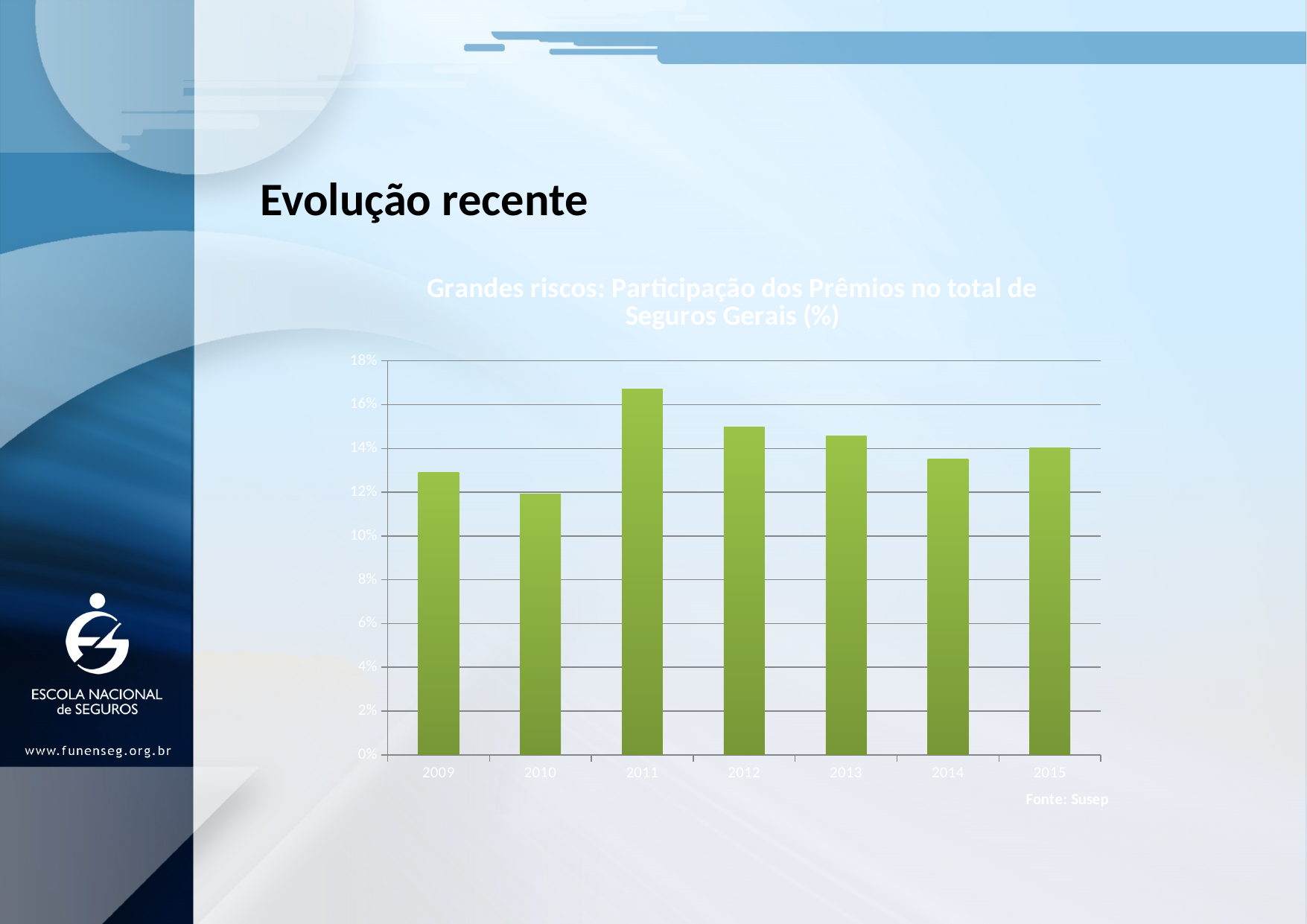
Is the value for 2009 greater or less than 14%? less What source is cited below the chart? Susep How many years are shown on the x axis of the chart? 7 Which year has the larger value, 2011 or 2012? 2011 Which year has the highest value in the chart? 2011 What kind of chart is shown on the slide? bar chart Is the value for 2014 greater or less than 14%? less Which year has the larger value, 2009 or 2010? 2009 Is the value for 2012 greater or less than 14%? greater Do the values rise or fall from 2011 to 2014? fall Which year has the lowest value in the chart? 2010